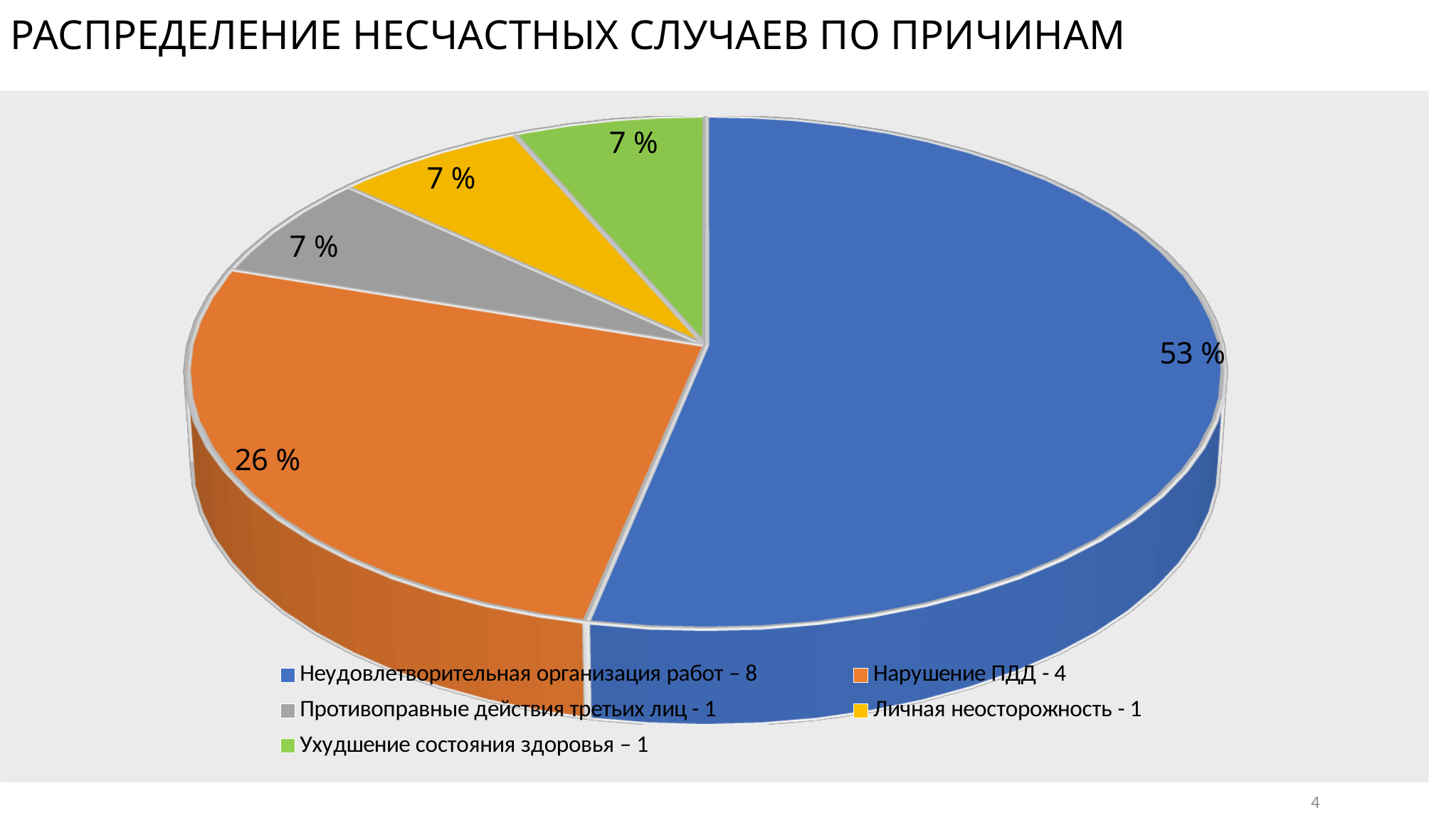
Which category has the largest slice of the pie? Неудовлетворительная организация работ What share of the pie is labelled for 'Неудовлетворительная организация работ'? 53 % Which slice is larger: 'Нарушение ПДД' or 'Ухудшение состояния здоровья'? Нарушение ПДД What is the title of the chart? РАСПРЕДЕЛЕНИЕ НЕСЧАСТНЫХ СЛУЧАЕВ ПО ПРИЧИНАМ By how many percentage points does the 'Неудовлетворительная организация работ' slice exceed the 'Нарушение ПДД' slice? 27 What is the smallest percentage shown on any slice of the pie? 7 % How many slices does the pie chart have? 5 According to the legend, how many cases are attributed to 'Нарушение ПДД'? 4 What share of the pie is labelled for 'Личная неосторожность'? 7 % What share of the pie is labelled for 'Нарушение ПДД'? 26 % What colour is the slice for 'Ухудшение состояния здоровья'? green What kind of chart is shown on the slide? pie chart